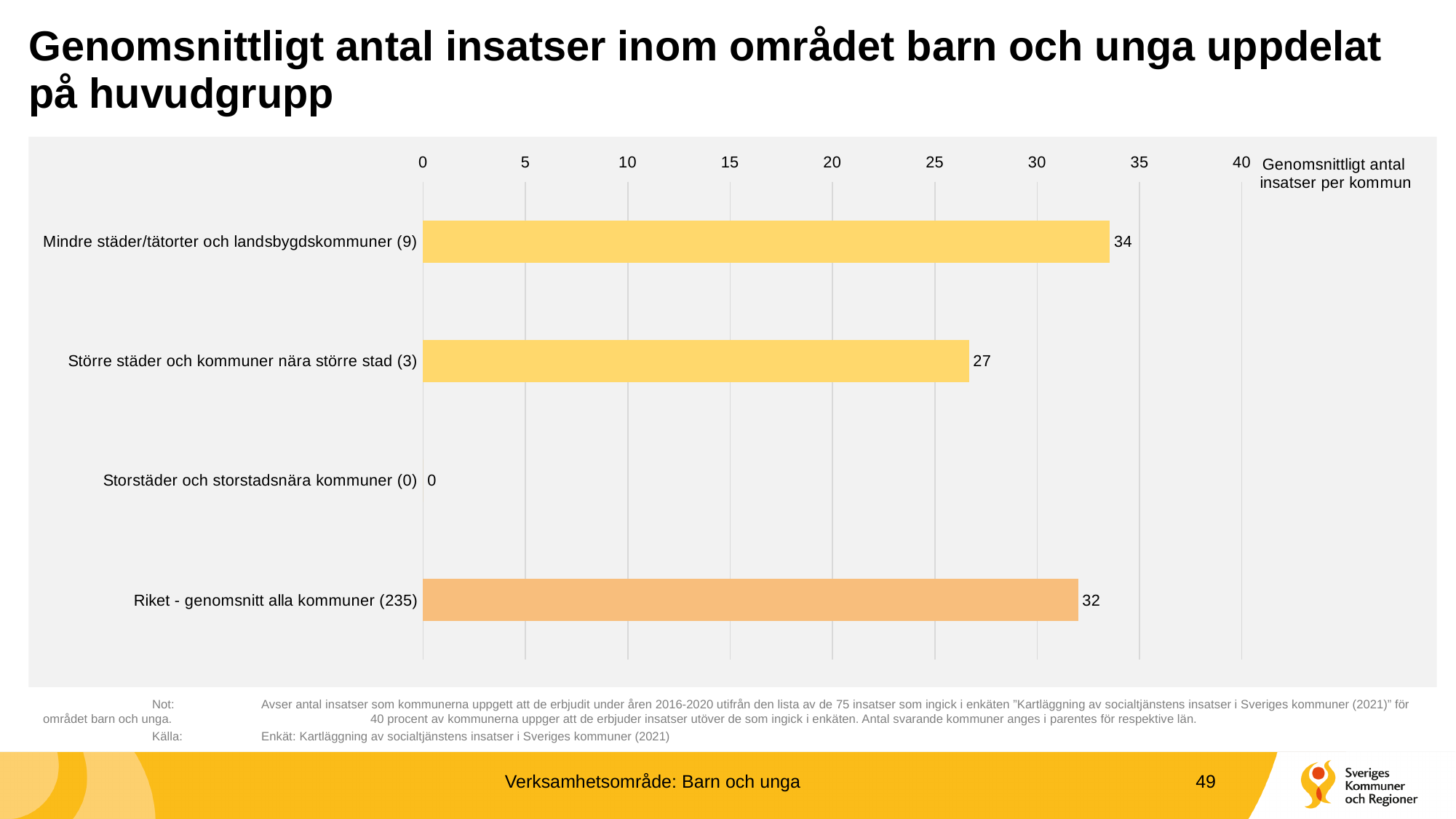
What is the difference between the values for Riket - genomsnitt alla kommuner (235) and Större städer och kommuner nära större stad (3)? 5 What is the difference between the values for Mindre städer/tätorter och landsbygdskommuner (9) and Större städer och kommuner nära större stad (3)? 7 How many categories are shown in the chart? 4 What is the value for Större städer och kommuner nära större stad (3)? 27 Which category has the highest value? Mindre städer/tätorter och landsbygdskommuner (9) What is the value for Mindre städer/tätorter och landsbygdskommuner (9)? 34 What is the value for Riket - genomsnitt alla kommuner (235)? 32 Which is larger: the value for Riket - genomsnitt alla kommuner (235) or the value for Mindre städer/tätorter och landsbygdskommuner (9)? Mindre städer/tätorter och landsbygdskommuner (9) What is the value for Storstäder och storstadsnära kommuner (0)? 0 Is the value for Större städer och kommuner nära större stad (3) greater or less than 30? less What kind of chart is shown on the slide? bar chart Which category has the lowest value? Storstäder och storstadsnära kommuner (0)